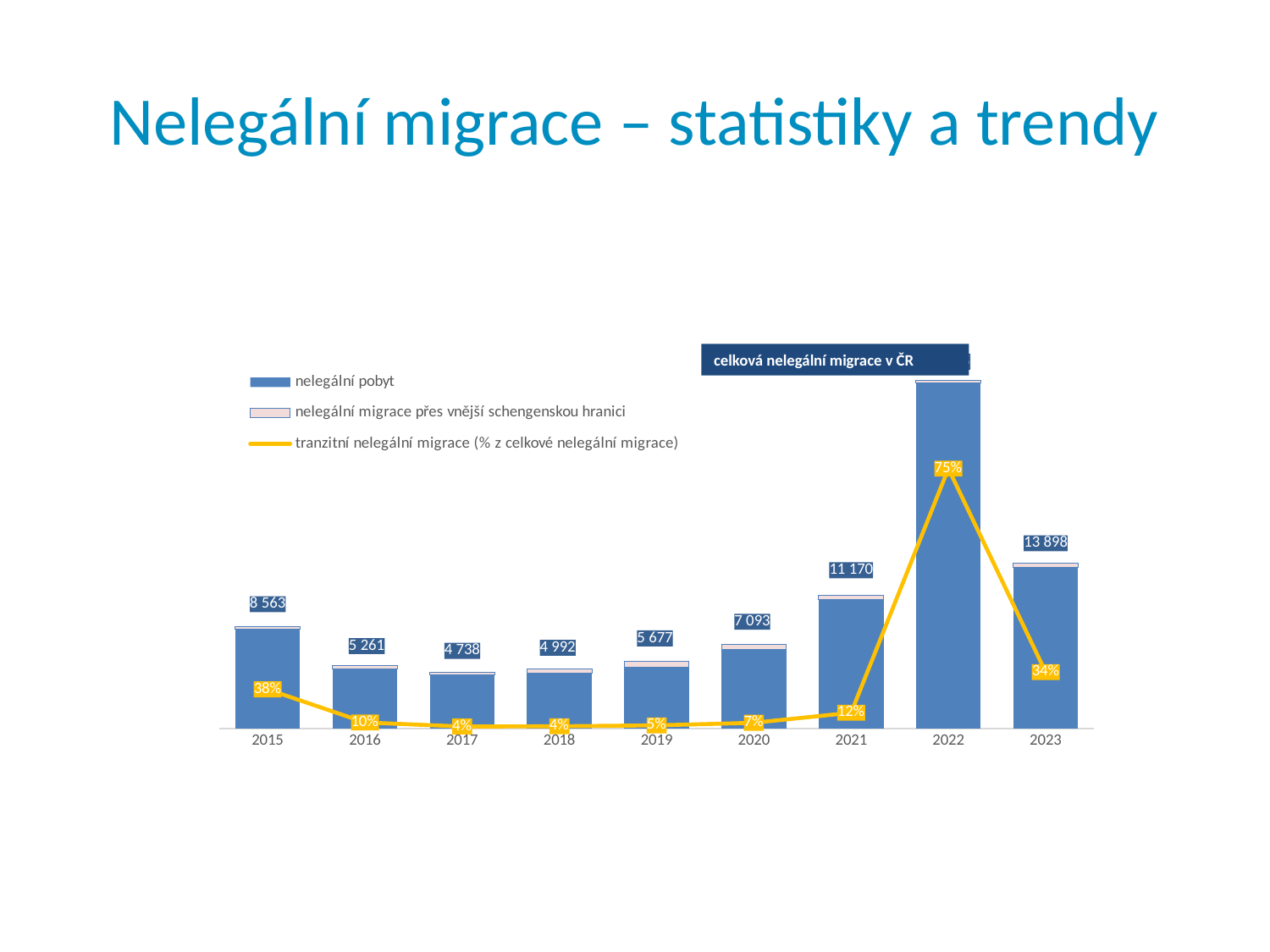
What percentage is shown for tranzitní nelegální migrace in 2015? 38% What is the data label on the bar for 2015? 8 563 What is the difference between the bar values for 2023 and 2021? 2 728 What value is labelled on the bar for 2023? 13 898 Which year has the larger bar value, 2019 or 2020? 2020 What kind of chart is this? Bar chart with a line series Which year has the lowest labelled bar value? 2017 Do the bar values rise or fall from 2017 to 2022? Rise How many series does the legend list? 3 What percentage is shown for tranzitní nelegální migrace in 2022? 75% Which year has the tallest bar? 2022 How many years are shown on the x axis? 9